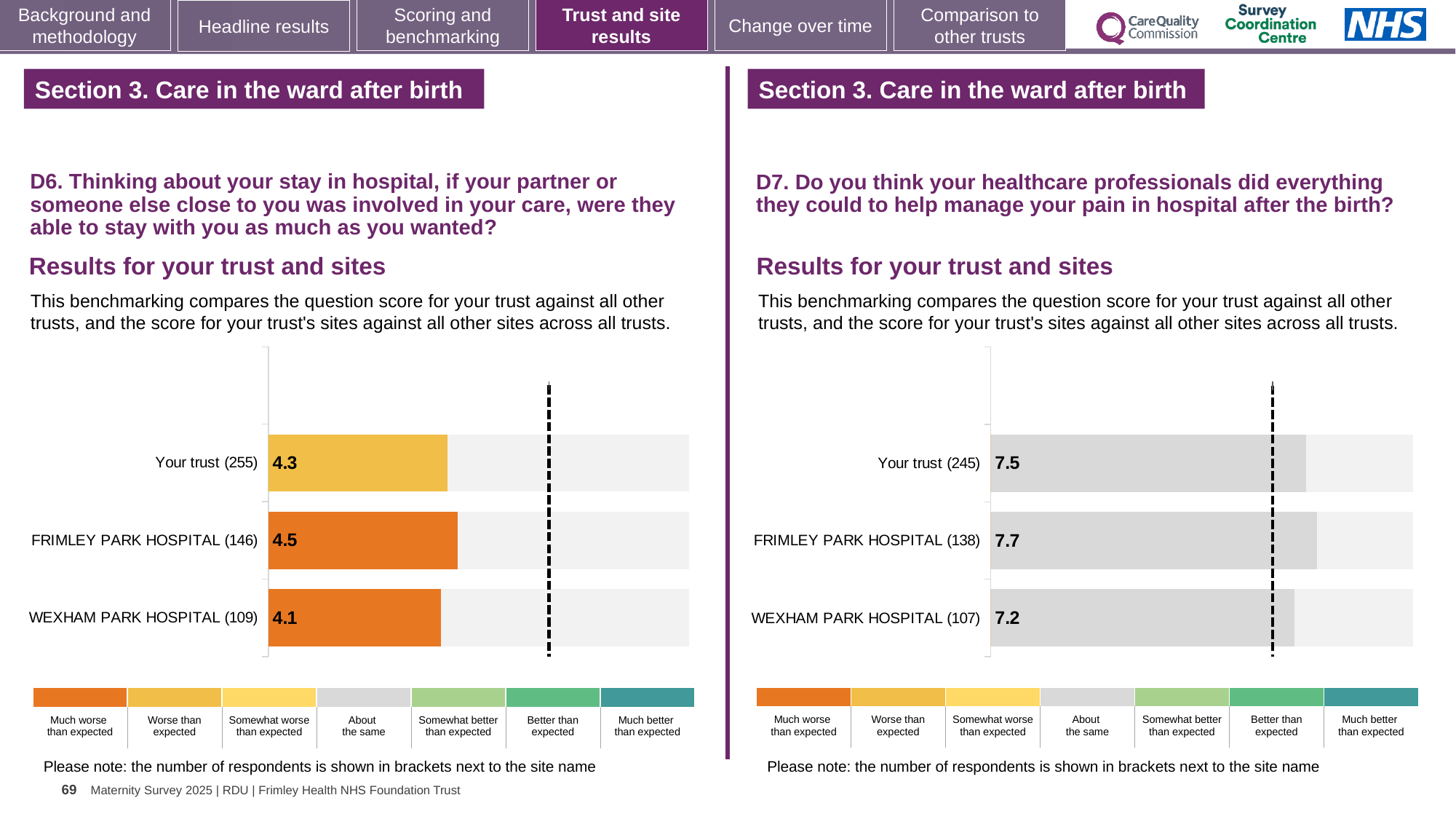
In the D6 chart on the left, what is the score for Your trust? 4.3 In the D7 chart on the right, what is the score for WEXHAM PARK HOSPITAL? 7.2 In the D6 chart on the left, what is the difference between the scores for FRIMLEY PARK HOSPITAL and WEXHAM PARK HOSPITAL? 0.4 In the D7 chart on the right, which site or trust has the highest score? FRIMLEY PARK HOSPITAL How many bars are plotted in the D7 chart on the right? 3 In the D6 chart on the left, what is the score for FRIMLEY PARK HOSPITAL? 4.5 In the D6 chart on the left, which site or trust has the lowest score? WEXHAM PARK HOSPITAL What type of chart is used in the D6 chart on the left? Bar chart In the D7 chart on the right, is the score for Your trust or for FRIMLEY PARK HOSPITAL larger? FRIMLEY PARK HOSPITAL In the D7 chart on the right, what is the difference between the scores for Your trust and WEXHAM PARK HOSPITAL? 0.3 In the D6 chart on the left, how many respondents are shown for WEXHAM PARK HOSPITAL? 109 In the D7 chart on the right, which benchmark category does the grey colour of the bars represent according to the legend? About the same